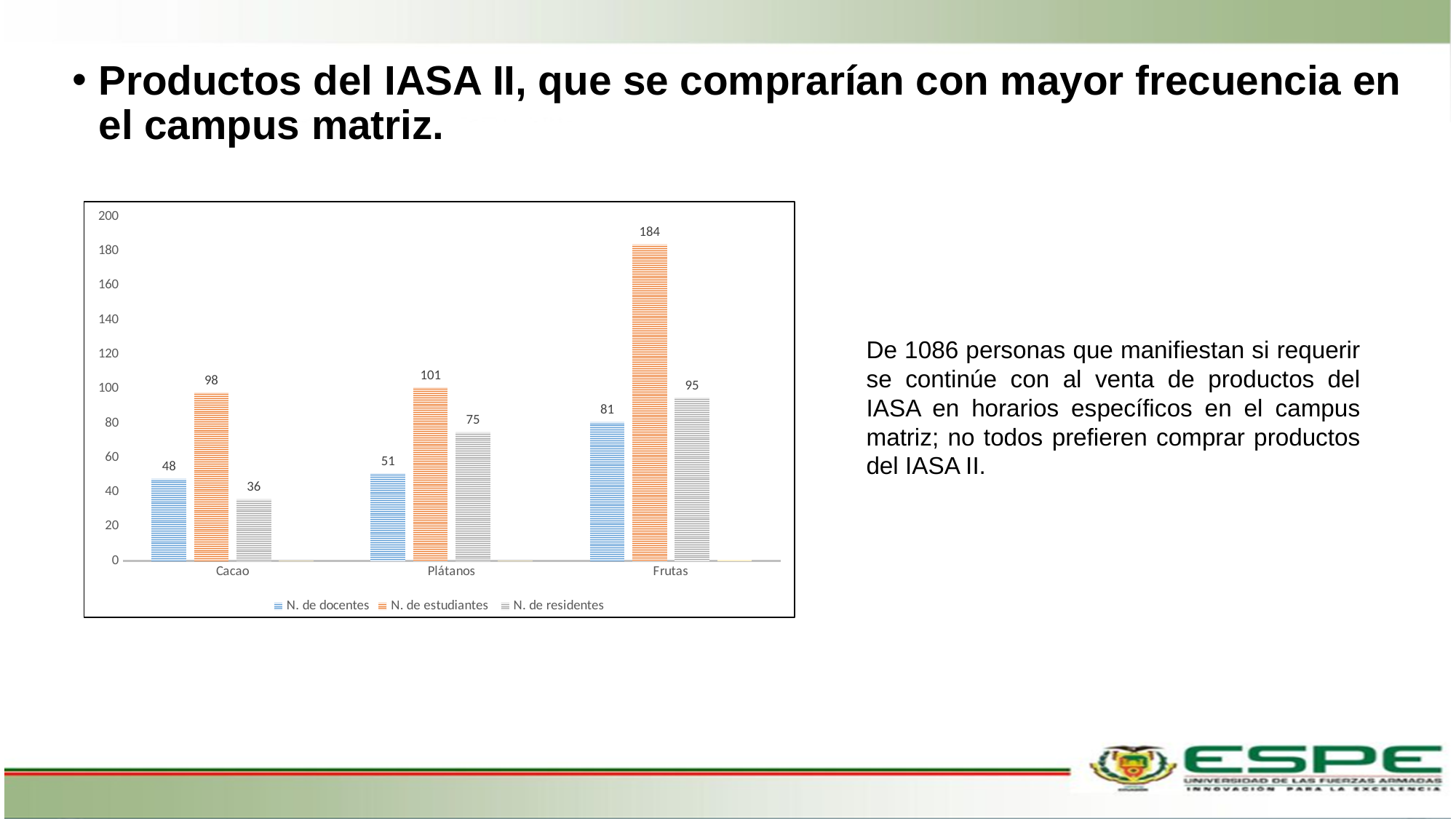
Which category has the highest value for N. de estudiantes? Frutas What is the value for N. de docentes for Cacao? 48 What is the value for N. de residentes for Plátanos? 75 Is the value for N. de estudiantes for Cacao greater or less than 100? less How many series does the legend list? 3 What kind of chart is shown on the slide? bar chart What is the value for N. de estudiantes for Frutas? 184 Which category has the lowest value for N. de residentes? Cacao Which is larger for Plátanos: N. de docentes or N. de residentes? N. de residentes Do the values for N. de docentes rise or fall from Cacao to Frutas? rise How many product categories are shown on the x axis? 3 What is the difference between N. de estudiantes and N. de docentes for Frutas? 103